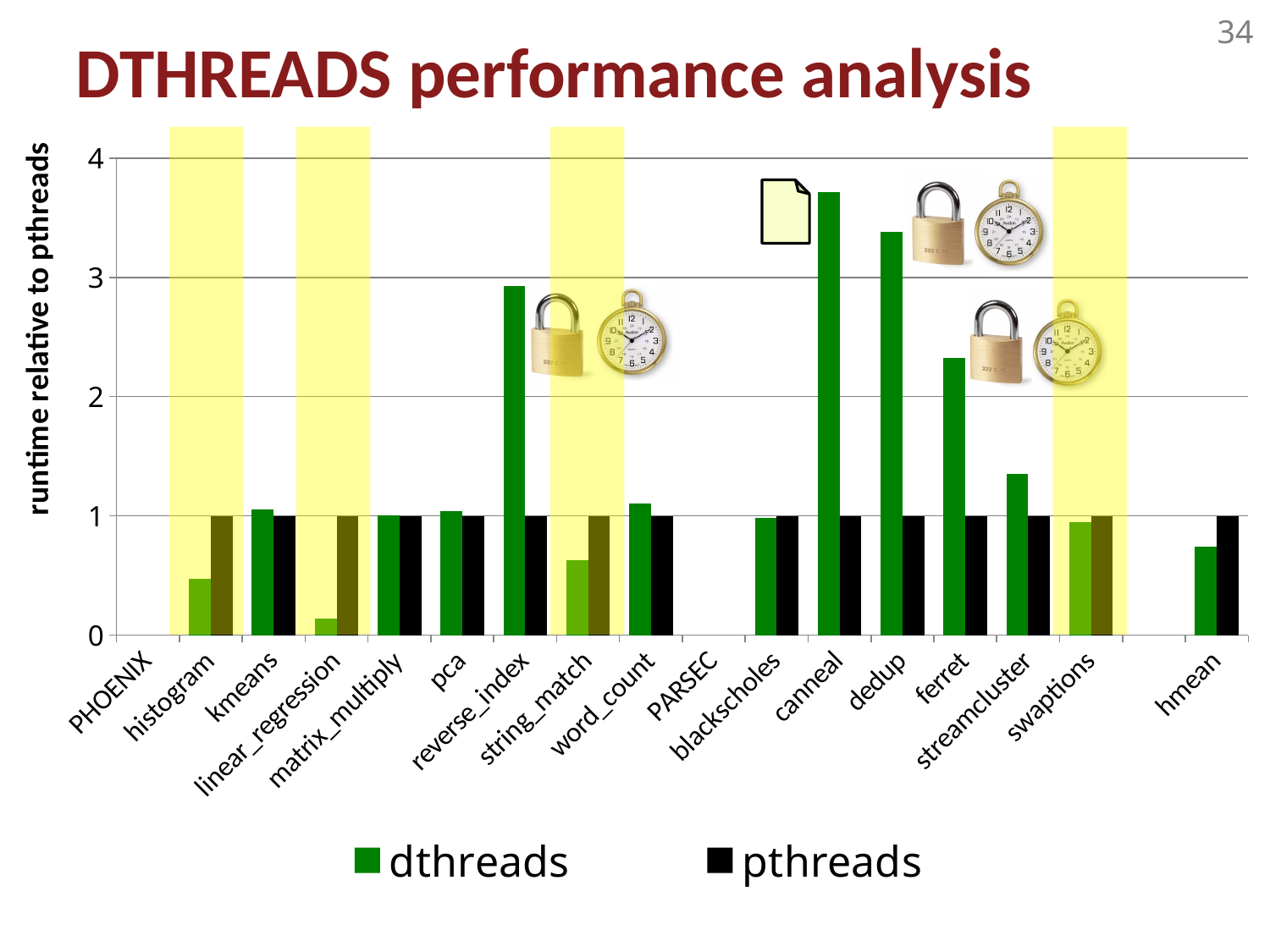
What kind of chart is shown on the slide? bar chart Which benchmark has the lowest dthreads runtime relative to pthreads? linear_regression Is the dthreads value for histogram greater or less than 1? less Is the dthreads value for dedup greater or less than 3? greater Is the dthreads value for hmean greater or less than 1? less What is the pthreads value for kmeans? 1 What are the two series named in the legend? dthreads and pthreads Which benchmark has the highest dthreads runtime relative to pthreads? canneal How many series does the legend list? 2 Which is larger, the dthreads value for ferret or the dthreads value for streamcluster? ferret What is the label of the vertical axis? runtime relative to pthreads